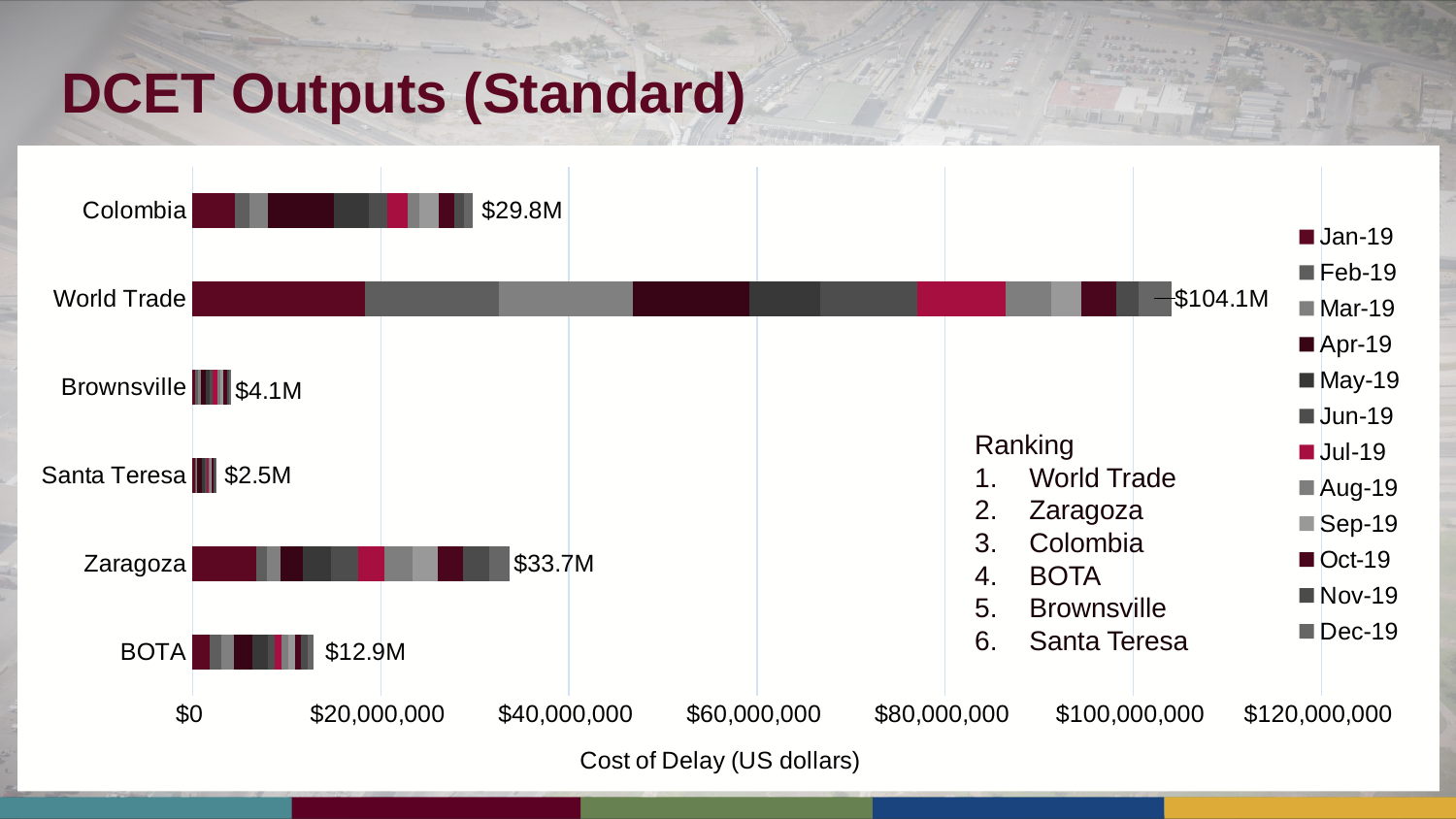
Which port of entry has the lowest total cost of delay? Santa Teresa Is the total cost of delay for World Trade greater or less than $100,000,000? greater What is the total cost of delay shown for Zaragoza? $33.7M What is the total cost of delay shown for World Trade? $104.1M What is the difference between the total cost of delay for BOTA and Brownsville? $8.8M How many series does the legend list? 12 How many ports of entry are shown on the chart? 6 What kind of chart is shown on the slide? Stacked bar chart Which has a larger total cost of delay, Colombia or BOTA? Colombia What is the difference between the total cost of delay for Zaragoza and Colombia? $3.9M What is the total cost of delay shown for Santa Teresa? $2.5M Which port of entry has the highest total cost of delay? World Trade